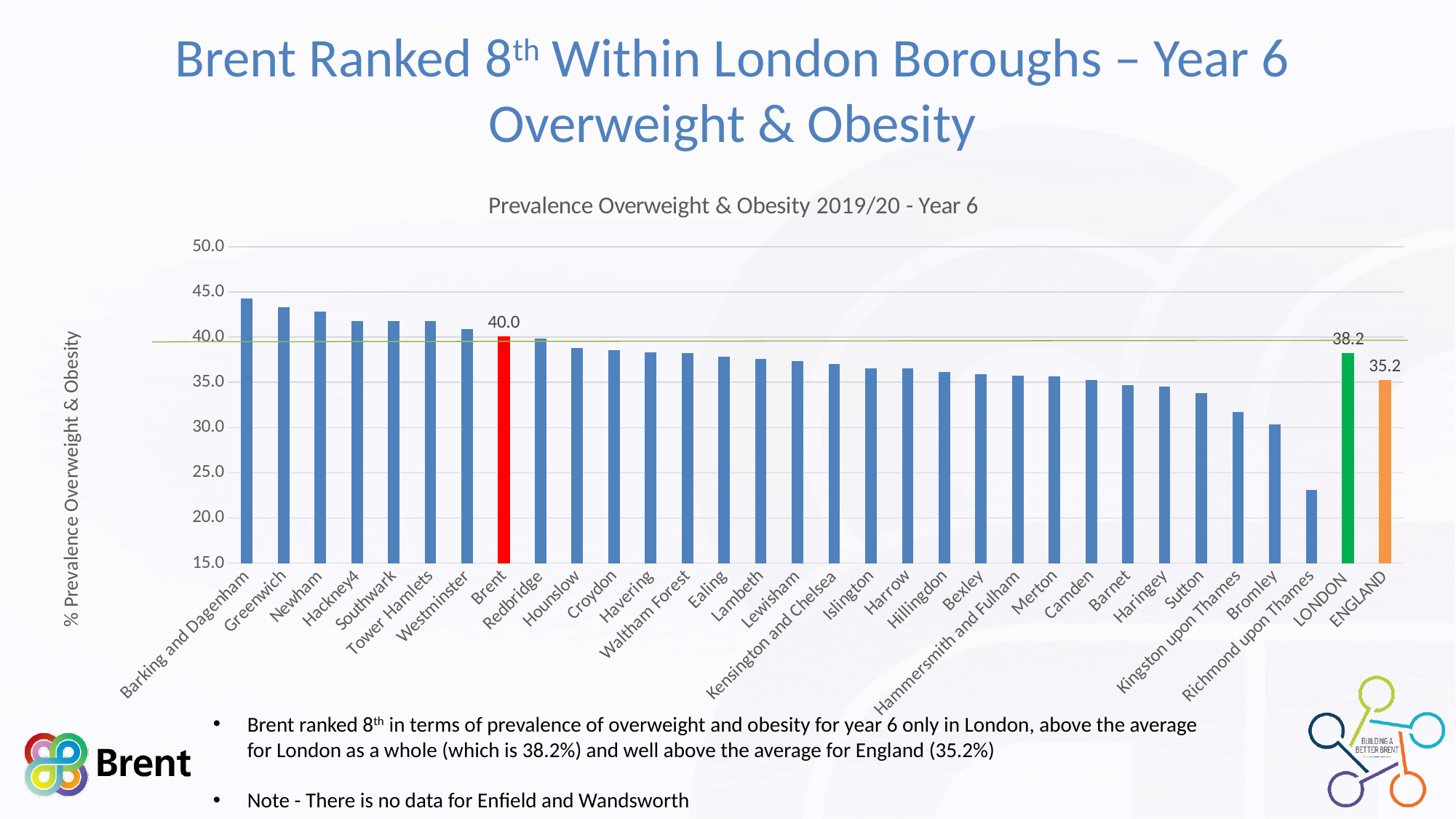
Which is larger, the value for Brent or the value for ENGLAND? Brent Is the value for Richmond upon Thames greater or less than 25.0? less What is the value for Brent? 40.0 What is the value for LONDON? 38.2 Which category has the lowest value? Richmond upon Thames What is the value for ENGLAND? 35.2 What is the difference between the values for Brent and LONDON? 1.8 How many bars are plotted in the chart? 32 What colour is the bar for Brent? Red Is the value for Barking and Dagenham greater or less than 40.0? greater What is the difference between the values for Brent and ENGLAND? 4.8 Which category has the highest value? Barking and Dagenham